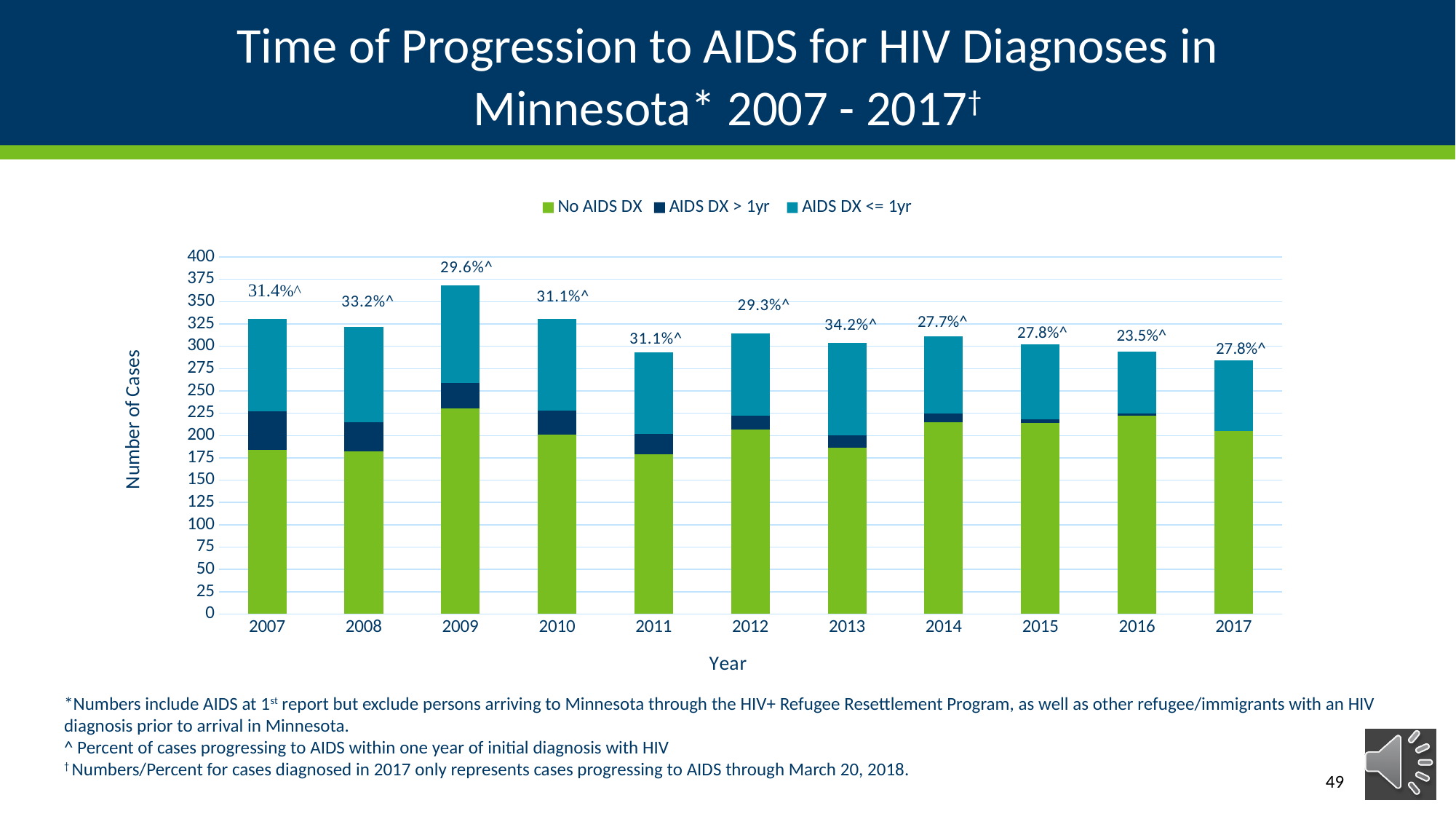
How many years are shown on the x axis? 11 Is the total height of the stacked bar for 2009 greater or less than 350? greater What percentage label is shown above the bar for 2009? 29.6%^ What kind of chart is shown on the slide? Stacked bar chart Which year has the highest percentage label above its bar? 2013 Which year has the larger percentage label, 2008 or 2012? 2008 What is the difference between the percentage labels for 2013 and 2016? 10.7 percentage points What percentage label is shown above the bar for 2013? 34.2%^ Which year has the lowest percentage label above its bar? 2016 What percentage label is shown above the bar for 2016? 23.5%^ Is the total height of the stacked bar for 2017 greater or less than 300? less How many series does the legend list? 3